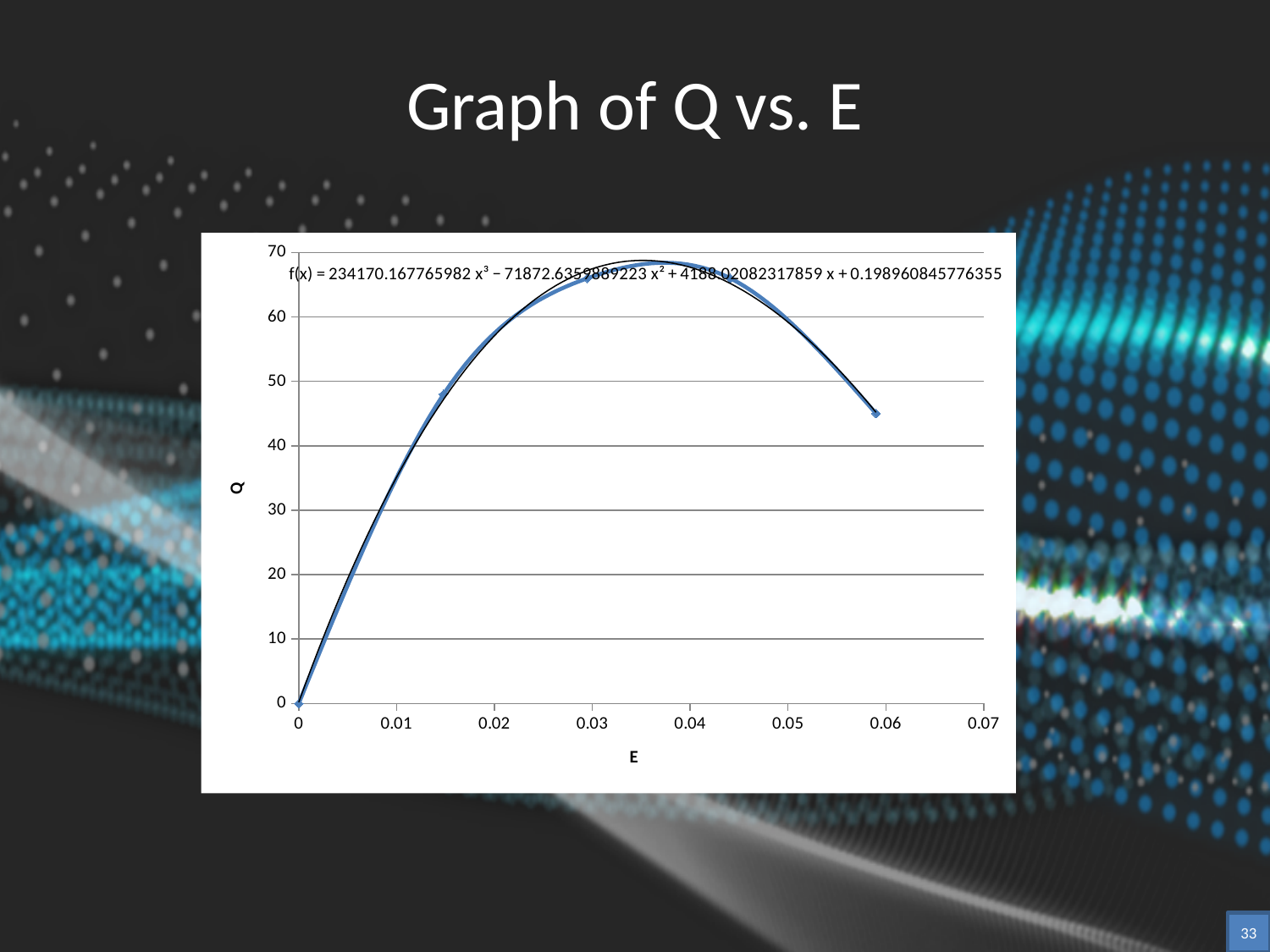
What kind of chart is shown on the slide? line chart What is the constant term in the fitted trendline equation f(x)? 0.198960845776355 Is the value of Q at the last data point (near E = 0.06) greater or less than 50? less What is the label on the horizontal axis of the chart? E What is the title of the chart? Graph of Q vs. E Is the peak value of Q on the curve greater or less than 60? greater Is the value of Q at the last data point (near E = 0.06) greater or less than 40? greater How does Q change as E increases from 0 to 0.06? rises then falls What is the value of Q at E = 0? 0 What is the highest value shown on the horizontal (E) axis? 0.07 What is the highest value shown on the vertical (Q) axis? 70